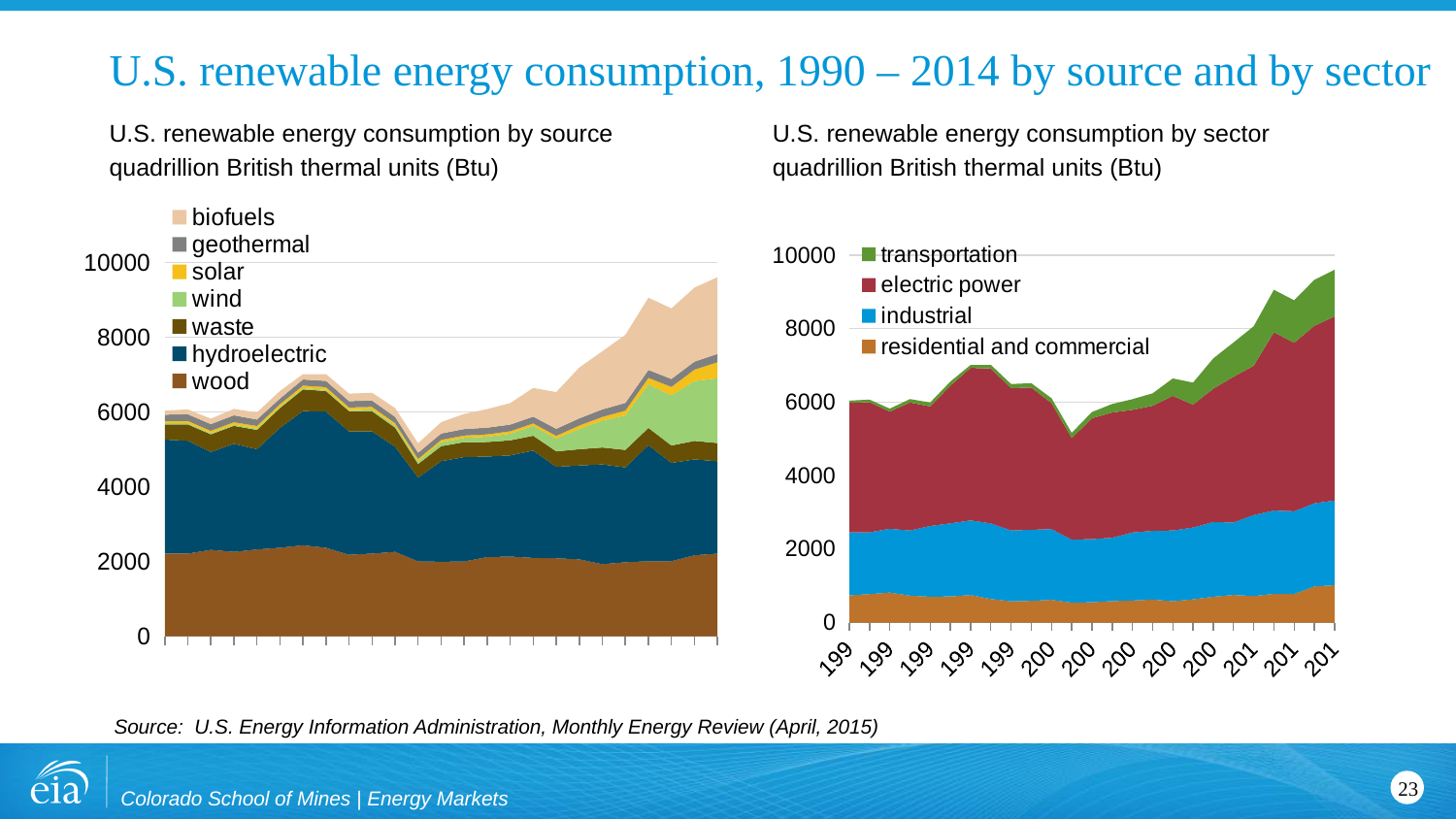
How many series does the legend of the right chart (by sector) list? 4 In the left chart (by source), does total renewable energy consumption rise or fall overall from the left end to the right end of the x axis? rise How many series does the legend of the left chart (by source) list? 7 In the left chart (by source), which series is plotted at the bottom of the stack? wood What unit is used on the y axis of both charts? quadrillion British thermal units (Btu) In the right chart (by sector), is the value for residential and commercial at the left end of the x axis greater or less than 2000? less In the right chart (by sector), is the value for residential and commercial at the right end of the x axis greater or less than 2000? less In the left chart (by source), is the total renewable energy consumption at the right end of the x axis greater or less than 8000? greater In the right chart (by sector), which sector accounts for the largest band of consumption? electric power What kind of chart is the left chart, 'U.S. renewable energy consumption by source'? stacked area chart In the right chart (by sector), does total renewable energy consumption rise or fall overall from the left end to the right end of the x axis? rise